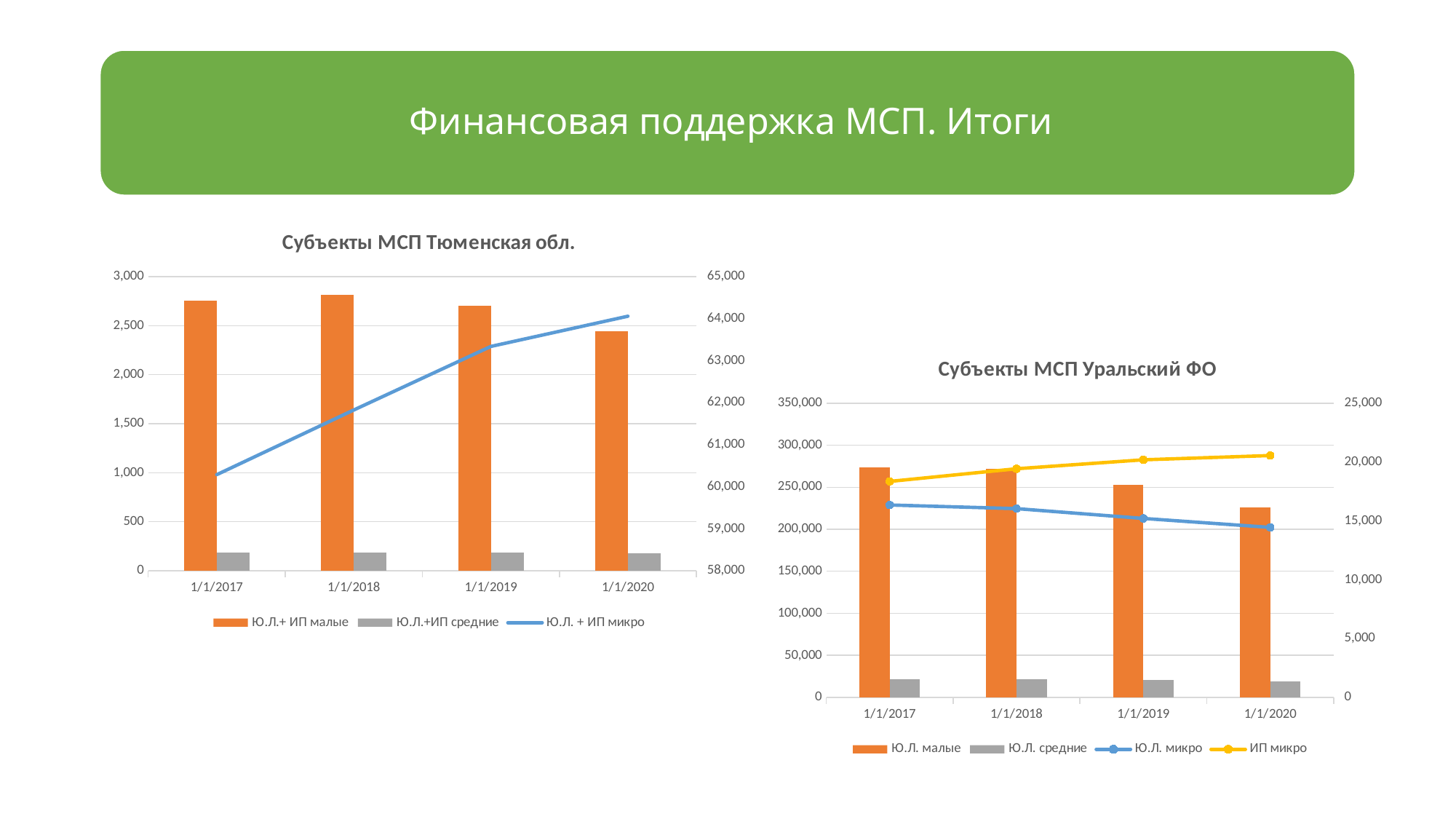
On the chart titled 'Субъекты МСП Уральский ФО', which date has the lowest 'Ю.Л. малые' bar? 1/1/2020 On the chart titled 'Субъекты МСП Тюменская обл.', does the 'Ю.Л. + ИП микро' line rise or fall from 1/1/2017 to 1/1/2020? Rises On the chart titled 'Субъекты МСП Тюменская обл.', how many dates are shown on the x axis? 4 On the chart titled 'Субъекты МСП Уральский ФО', what colour is the 'ИП микро' line? Yellow On the chart titled 'Субъекты МСП Тюменская обл.', what kind of chart is it? A combined bar and line chart On the chart titled 'Субъекты МСП Тюменская обл.', how many series does the legend list? 3 On the chart titled 'Субъекты МСП Тюменская обл.', which date has the lowest 'Ю.Л.+ ИП малые' bar? 1/1/2020 On the chart titled 'Субъекты МСП Тюменская обл.', is the 'Ю.Л.+ ИП малые' value for 1/1/2020 greater or less than 2,500? less On the chart titled 'Субъекты МСП Уральский ФО', at 1/1/2020, which is larger: 'ИП микро' or 'Ю.Л. микро'? ИП микро On the chart titled 'Субъекты МСП Уральский ФО', how many series does the legend list? 4 On the chart titled 'Субъекты МСП Уральский ФО', does the 'Ю.Л. микро' line rise or fall from 1/1/2017 to 1/1/2020? Falls